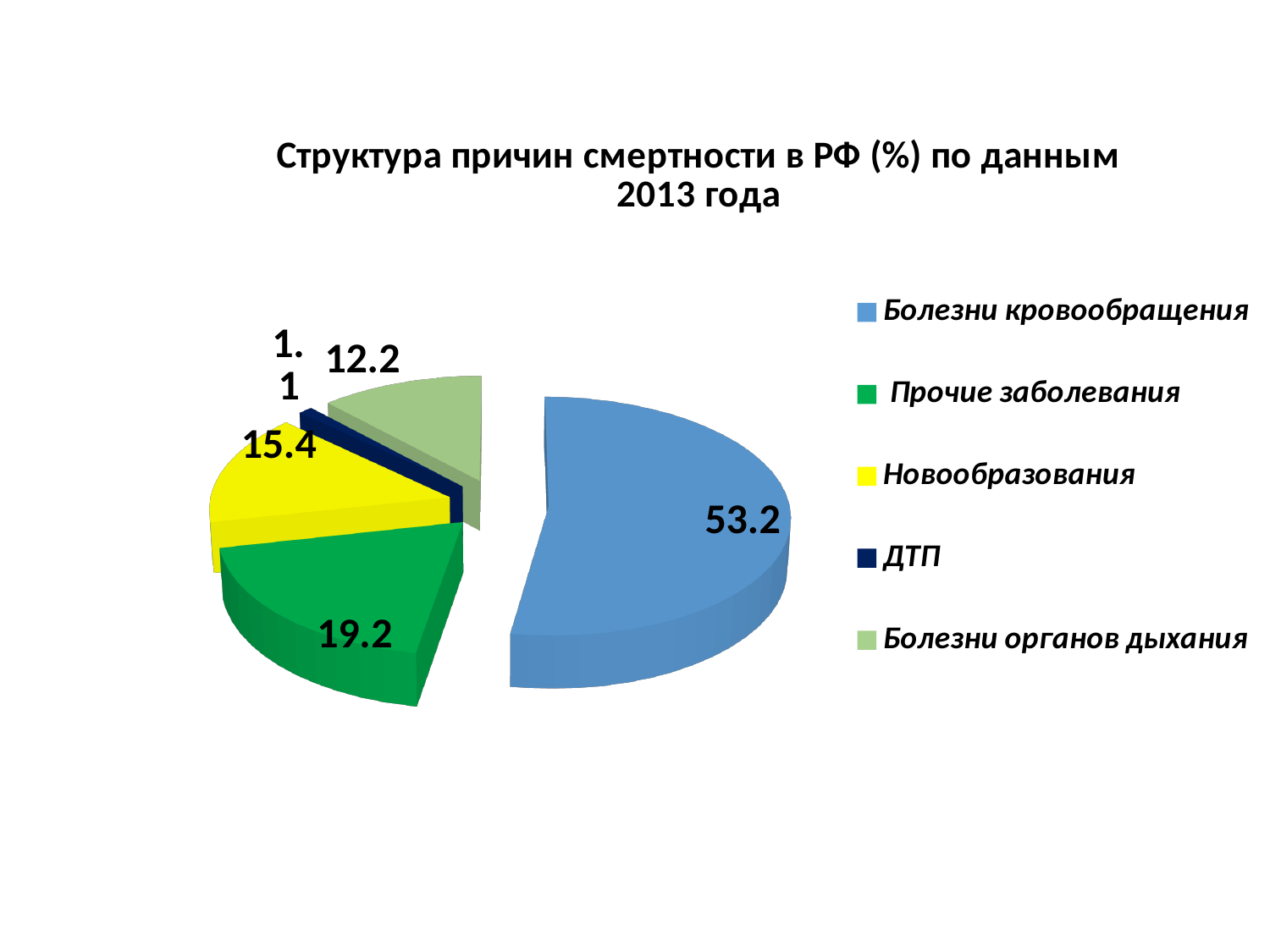
What value is shown for Новообразования? 15.4 What value is shown for Болезни органов дыхания? 12.2 What colour is the slice for Новообразования? Yellow Which is larger, the value for Новообразования or the value for Болезни органов дыхания? Новообразования What is the difference between the values for Болезни кровообращения and Прочие заболевания? 34 What value is shown for Болезни кровообращения? 53.2 What kind of chart is shown on the slide? Pie chart How many categories are shown in the pie chart? 5 Which category has the smallest slice of the pie? ДТП What is the title of the chart? Структура причин смертности в РФ (%) по данным 2013 года Which category has the largest slice of the pie? Болезни кровообращения What value is shown for Прочие заболевания? 19.2